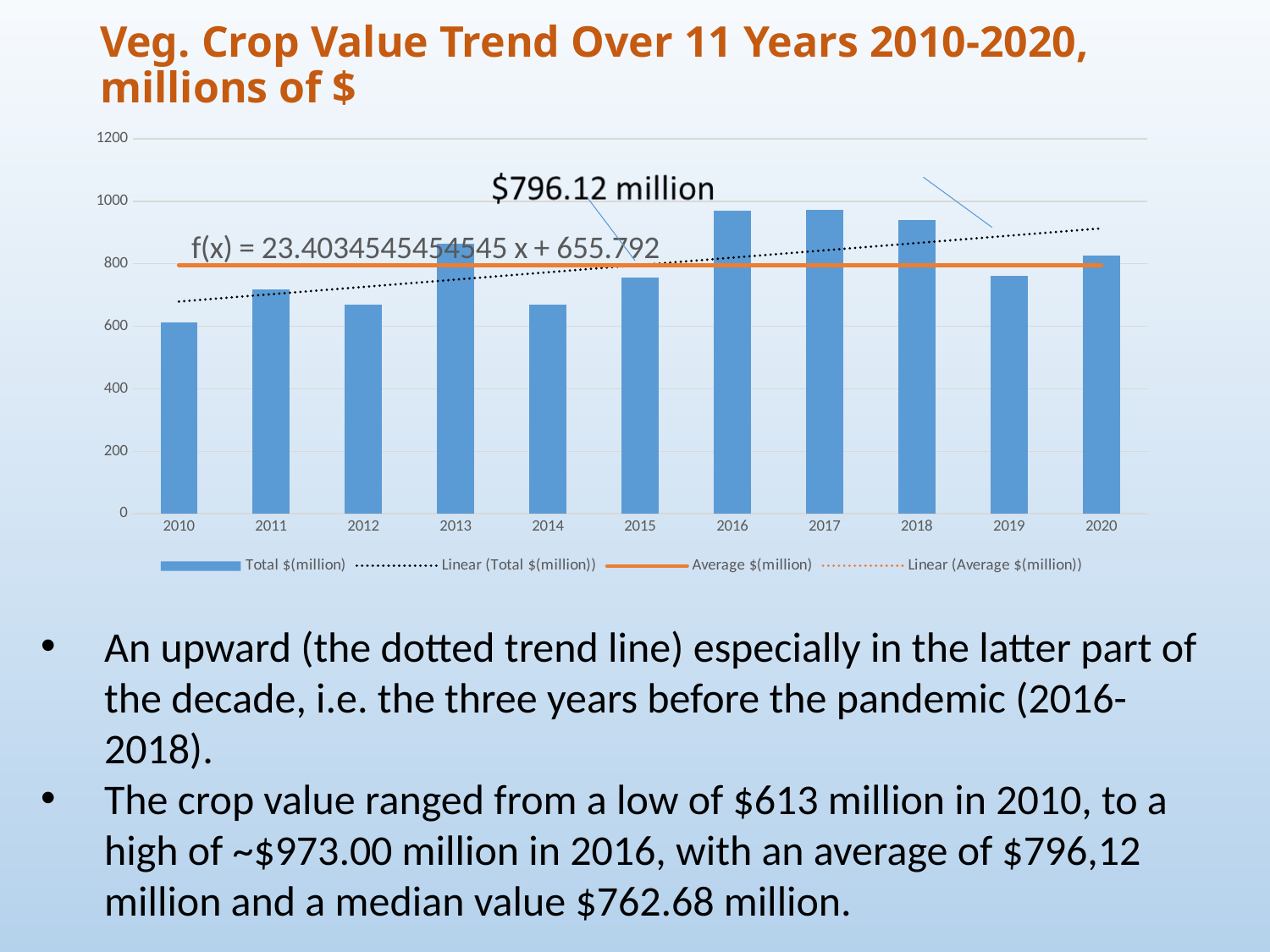
What average value is annotated on the chart? $796.12 million Which year has the lowest bar in the chart? 2010 How many entries does the chart's legend list? 4 Is the value for 2019 greater or less than 800? less How many years are plotted along the x axis of the chart? 11 What trend line equation is printed on the chart? f(x) = 23.4034545454545 x + 655.792 Is the value for 2018 greater or less than 800? greater Does the dotted trend line for Total $(million) rise or fall from 2010 to 2020? rise What kind of chart is shown on the slide? bar chart Which year has the larger bar, 2013 or 2014? 2013 Is the value for 2010 greater or less than 800? less